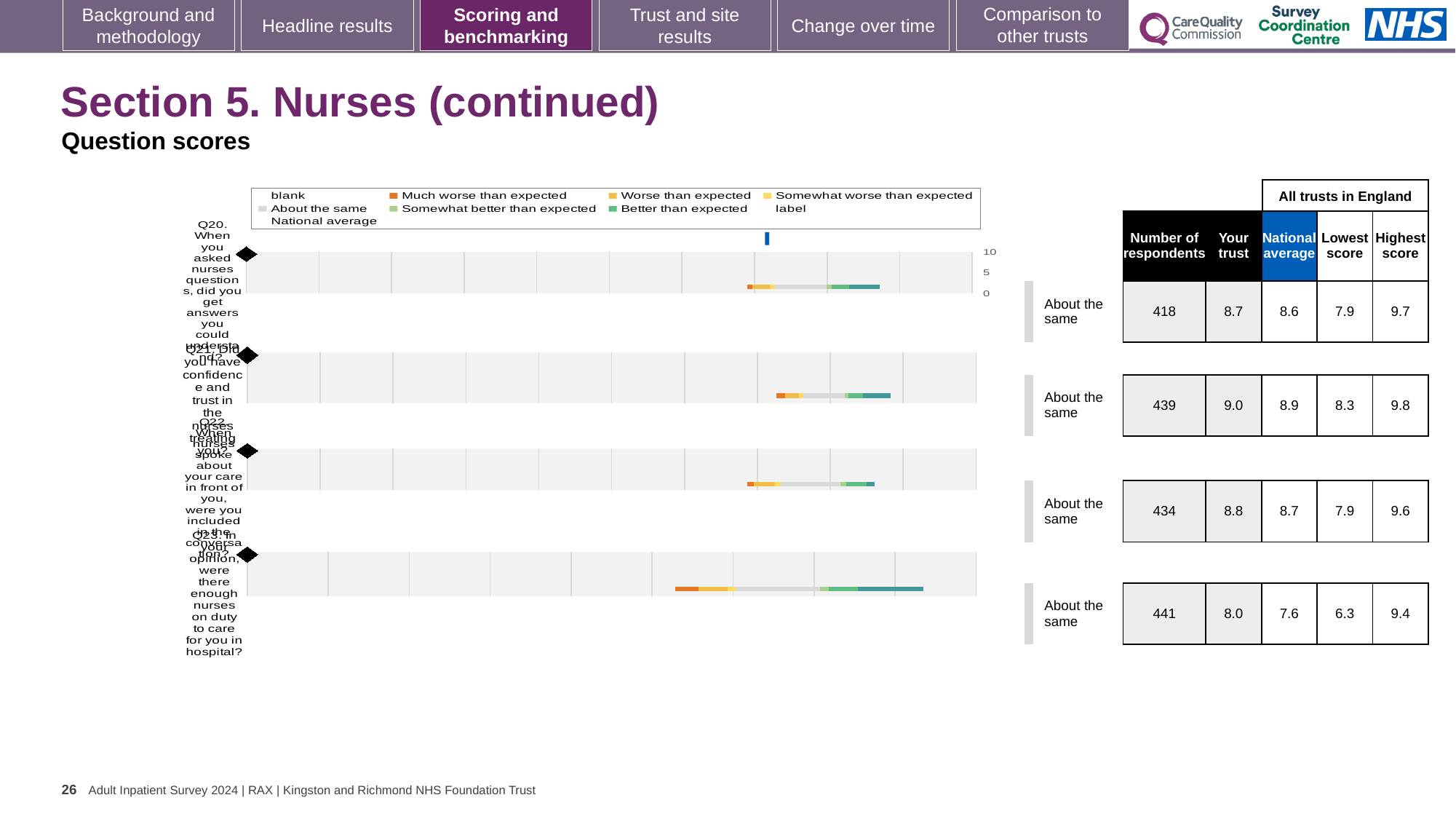
Which legend entry is shown in orange in the chart's legend? Much worse than expected Which question has the lowest national average in the table beside the chart? Q23 In the table beside the chart, what is the number of respondents for Q23 (were there enough nurses on duty to care for you in hospital)? 441 How many questions (categories) are plotted in the chart? 4 What kind of chart is shown on the slide? bar chart Which question has the highest 'Your trust' score in the table beside the chart? Q21 What is the difference between the 'Your trust' score and the national average for Q23? 0.4 In the table beside the chart, what is the highest score across all trusts in England for Q22? 9.6 In the table beside the chart, what is the national average for Q21 (Did you have confidence and trust in the nurses treating you)? 8.9 What is the highest value shown on the chart's axis? 10 What benchmark category is shown for each of the four questions on the slide? About the same In the table beside the chart, what is the 'Your trust' score for Q20 (When you asked nurses questions, did you get answers you could understand)? 8.7